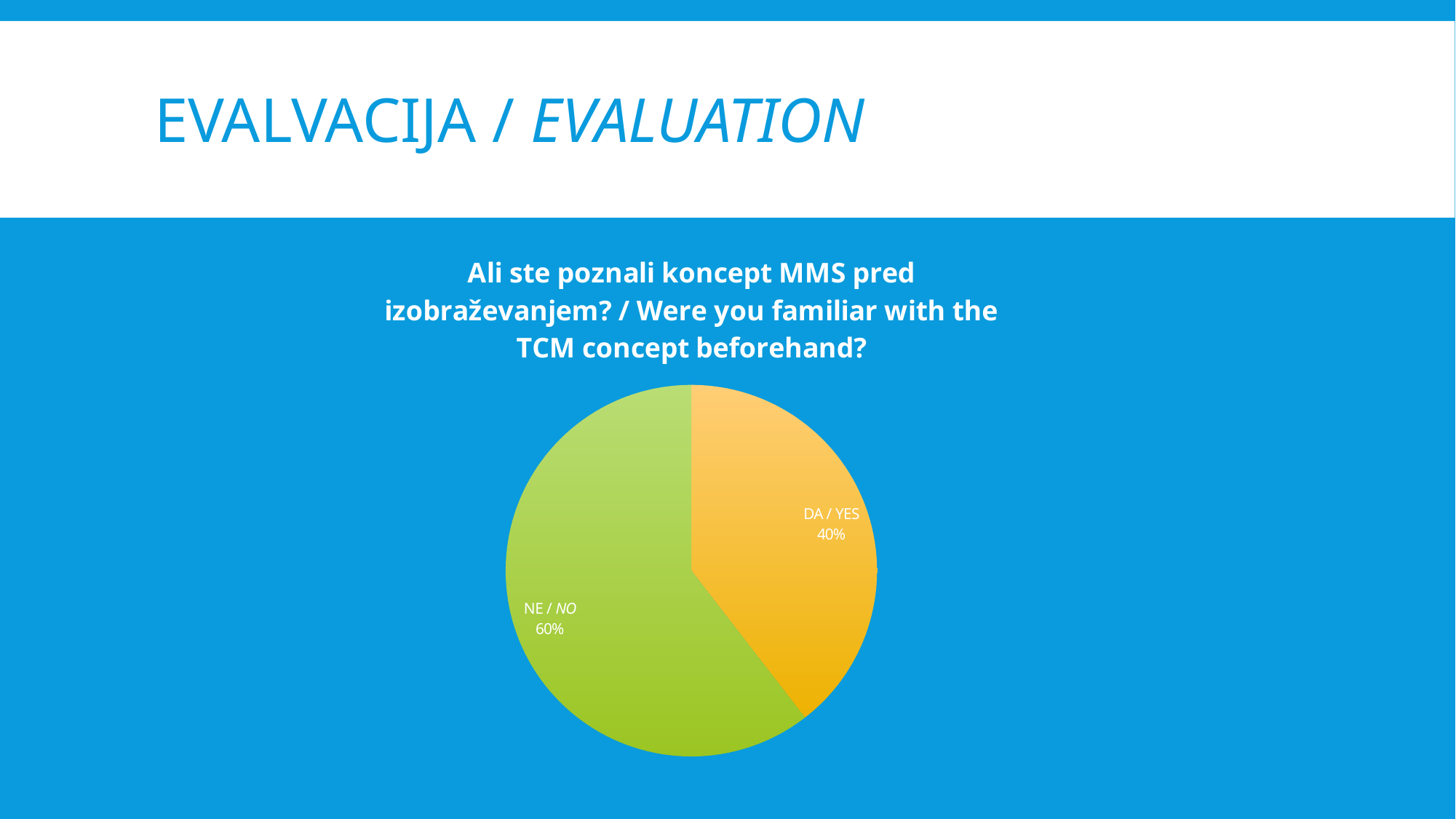
What type of chart is shown on the slide? pie chart Which is larger, the DA / YES slice or the NE / NO slice? NE / NO How many slices does the pie chart have? 2 Which response has the largest share of the pie? NE / NO What is the difference in percentage points between the NE / NO and DA / YES slices? 20 What percentage of respondents answered DA / YES? 40% What percentage of respondents answered NE / NO? 60% Which response has the smallest share of the pie? DA / YES What is the title of the pie chart? Ali ste poznali koncept MMS pred izobraževanjem? / Were you familiar with the TCM concept beforehand? What colour is the DA / YES slice? orange What share of the pie does the NE / NO slice represent? 60%